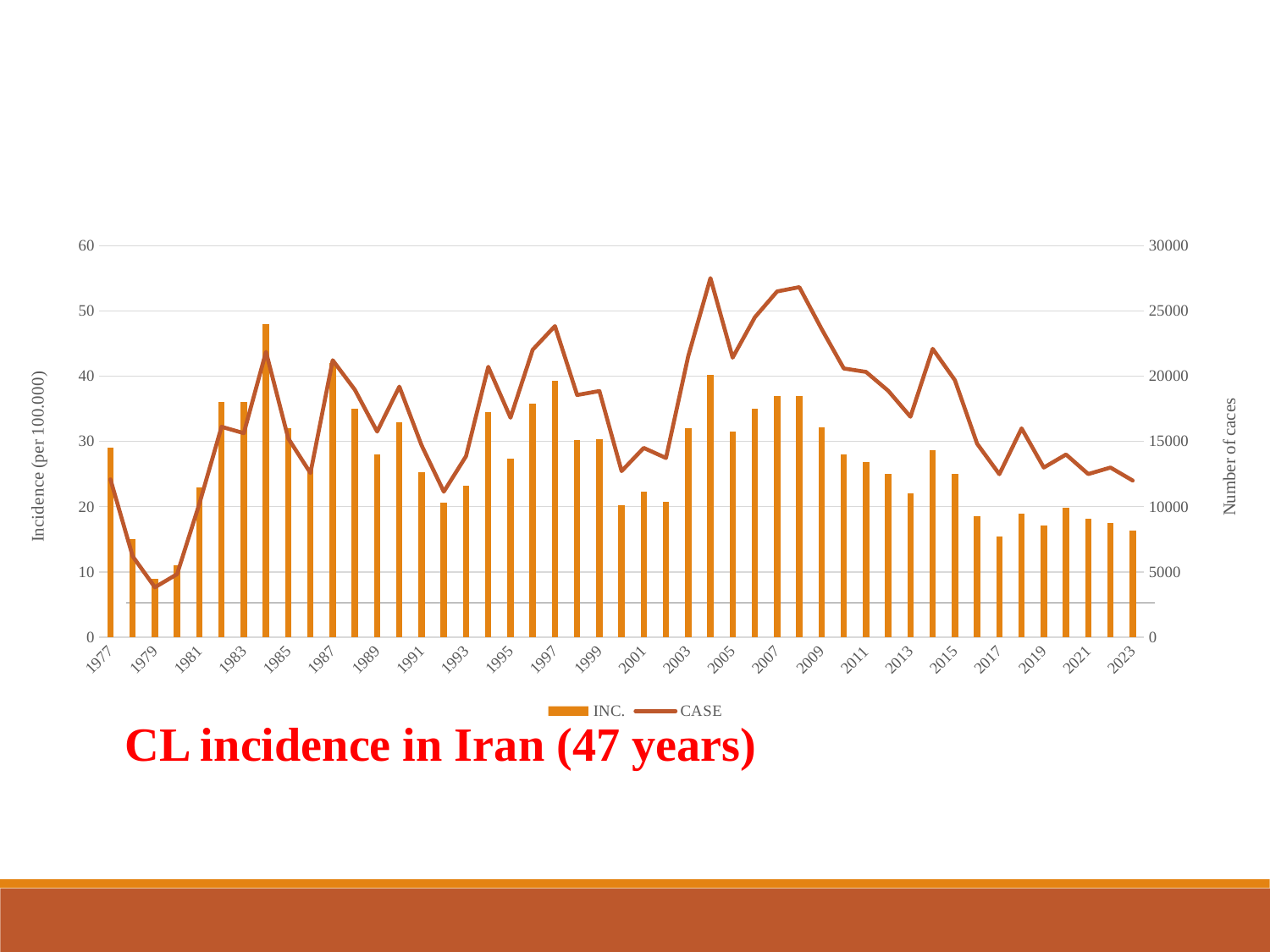
What is the title of the chart? CL incidence in Iran (47 years) What are the two series named in the legend? INC. and CASE Is the INC. value for 1984 greater or less than 40? greater In which year is the INC. bar the highest? 1984 How many years of data are plotted in the chart? 47 Is the INC. value for 2023 greater or less than 20? less Do the INC. bars generally rise or fall from 2008 to 2023? fall How many series does the legend list? 2 Which year has the larger INC. bar, 1997 or 2023? 1997 In which year is the INC. bar the lowest? 1979 Is the CASE value for 2004 greater or less than 25000? greater What kind of chart is shown on the slide? A bar chart combined with a line chart